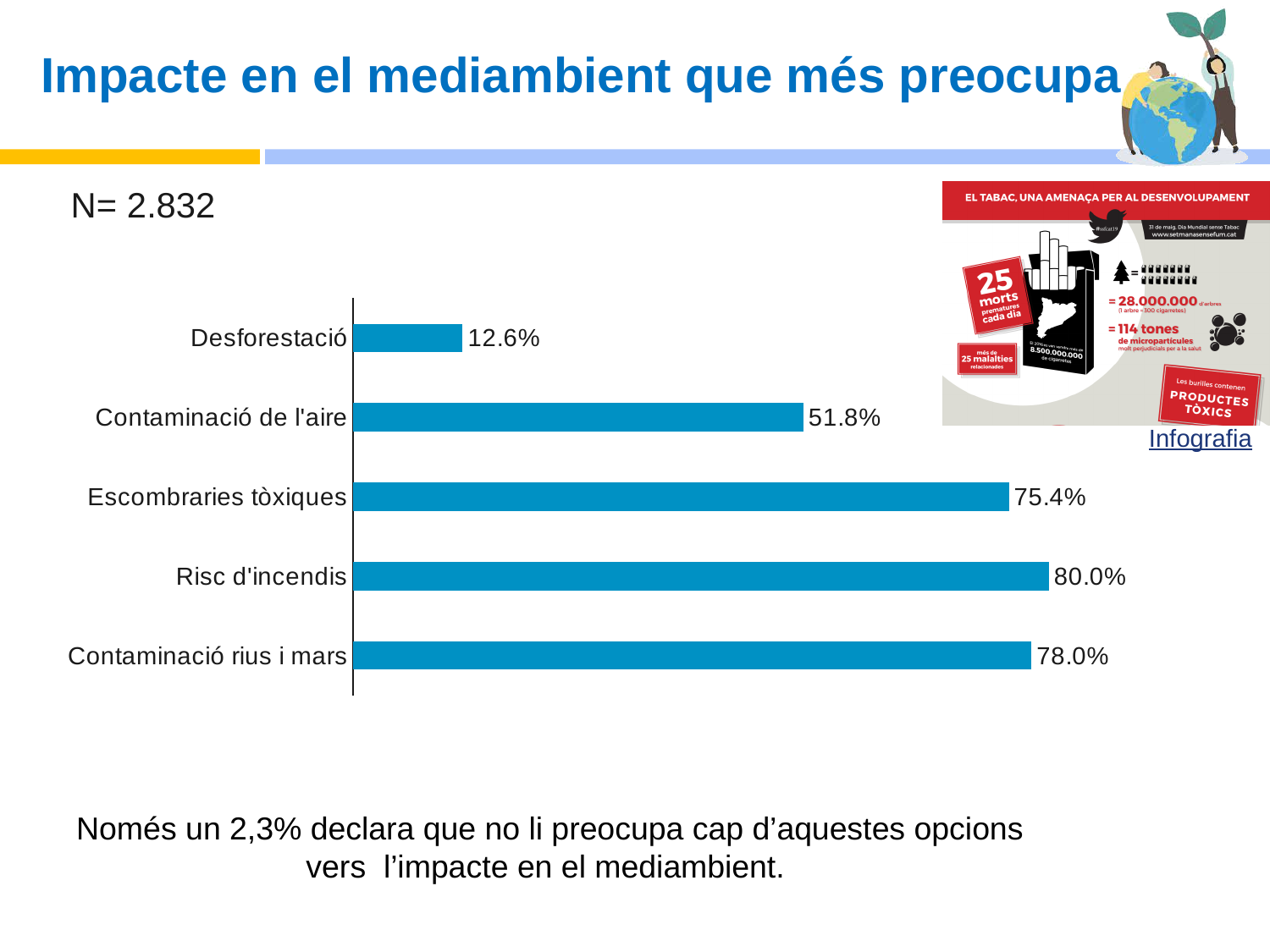
Which category has the lowest value? Desforestació Which is larger, the value for Contaminació rius i mars or the value for Escombraries tòxiques? Contaminació rius i mars What is the value for Contaminació rius i mars? 78.0% What is the value for Risc d'incendis? 80.0% What sample size (N) is stated on the slide for the chart? 2.832 What kind of chart is shown on the slide? Bar chart How many categories are shown in the chart? 5 What is the difference between the values for Escombraries tòxiques and Contaminació de l'aire? 23.6% What is the value for Contaminació de l'aire? 51.8% Which category has the highest value? Risc d'incendis What is the difference between the values for Risc d'incendis and Desforestació? 67.4% What is the value for Desforestació? 12.6%